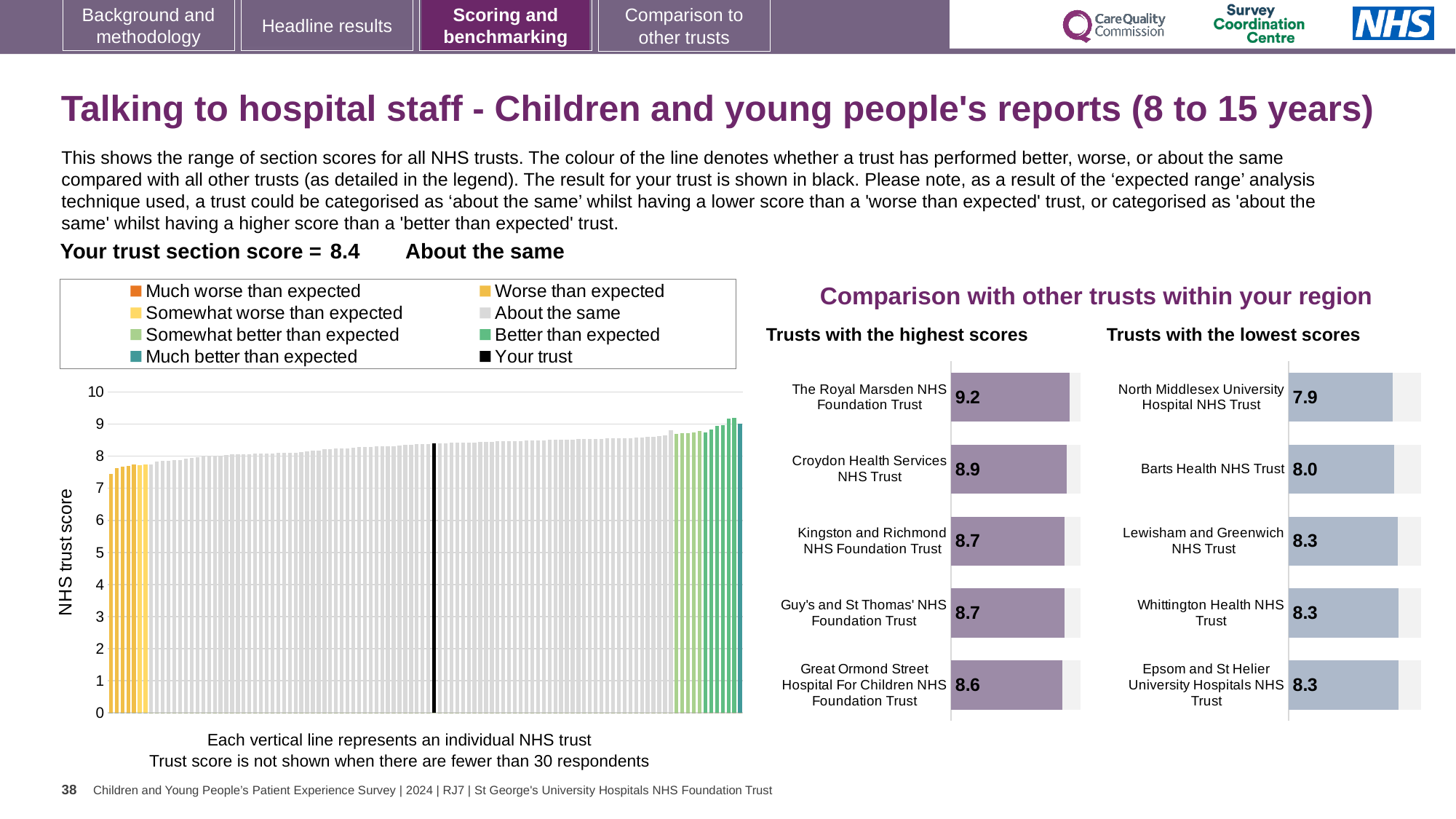
In the 'Trusts with the highest scores' chart, what is the score for The Royal Marsden NHS Foundation Trust? 9.2 In the 'Trusts with the highest scores' chart, which trust has the highest score? The Royal Marsden NHS Foundation Trust What kind of chart is the large chart on the left showing NHS trust scores? Bar chart In the 'Trusts with the highest scores' chart, what is the difference between the scores of The Royal Marsden NHS Foundation Trust and Great Ormond Street Hospital For Children NHS Foundation Trust? 0.6 In the 'Trusts with the lowest scores' chart, which trust has the lowest score? North Middlesex University Hospital NHS Trust How many trusts are shown in the 'Trusts with the lowest scores' chart? 5 In the 'Trusts with the lowest scores' chart, which has the larger score: Barts Health NHS Trust or North Middlesex University Hospital NHS Trust? Barts Health NHS Trust How many entries does the legend of the large chart on the left list? 8 What is the y-axis label of the large chart on the left? NHS trust score In the 'Trusts with the highest scores' chart, what is the score for Great Ormond Street Hospital For Children NHS Foundation Trust? 8.6 In the large chart on the left, is the value for the lowest-scoring trust greater or less than 7? greater In the 'Trusts with the lowest scores' chart, what is the score for Barts Health NHS Trust? 8.0